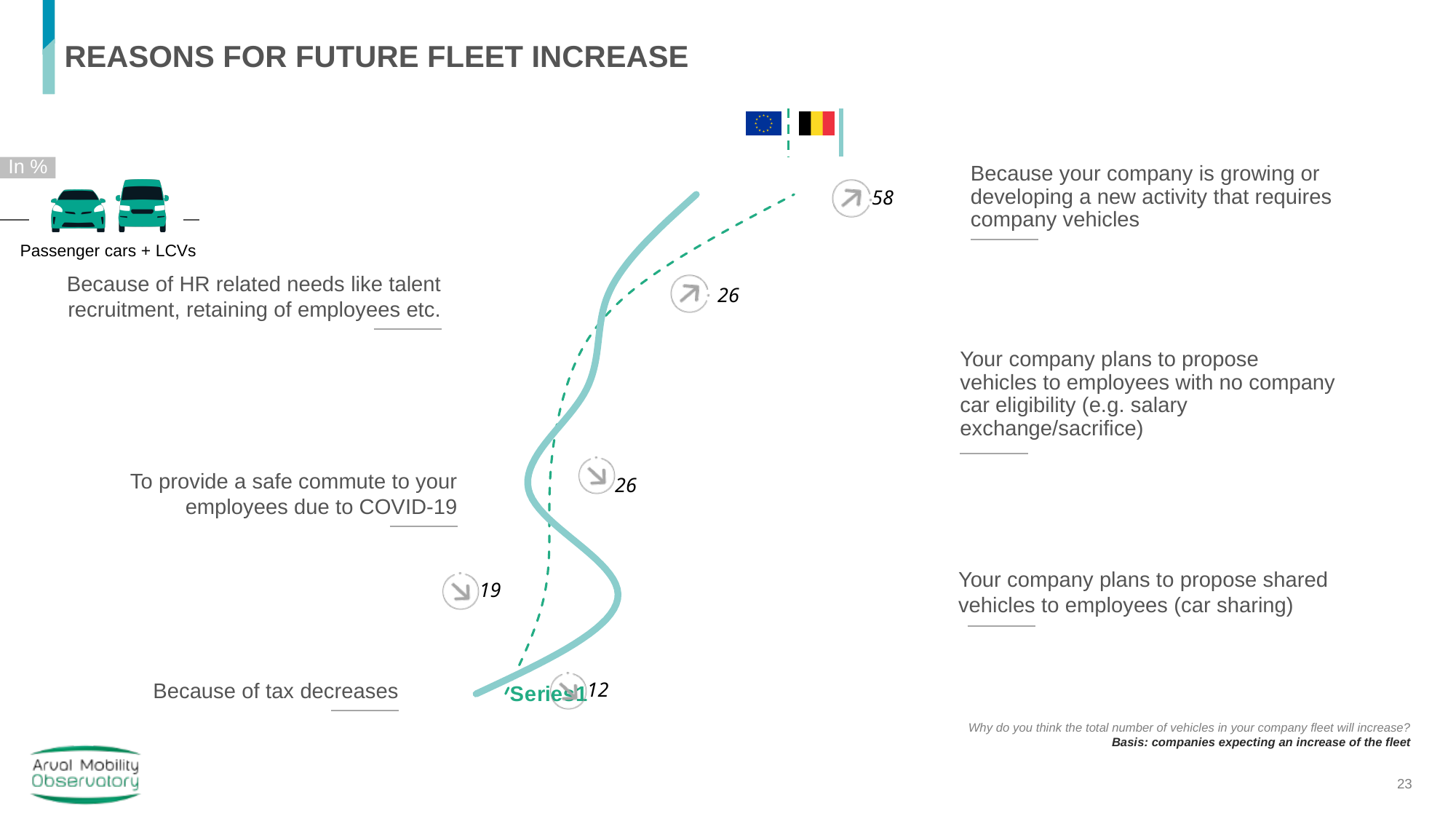
What value is shown for "Your company plans to propose shared vehicles to employees (car sharing)"? 19 What is the title of the slide? REASONS FOR FUTURE FLEET INCREASE In what unit are the values on the chart expressed? % What is the difference between the value for the company growing reason (58) and the tax decreases reason (12)? 46 What kind of chart is shown on the slide? Line chart Which has a larger value: the company growing reason or the car sharing reason? The company growing reason What value is shown for "Because your company is growing or developing a new activity that requires company vehicles"? 58 What value is shown for "Because of tax decreases"? 12 How many reasons (categories) are listed on the chart? 6 Which reason has the highest value shown on the chart? Because your company is growing or developing a new activity that requires company vehicles Which reason has the lowest value shown on the chart? Because of tax decreases